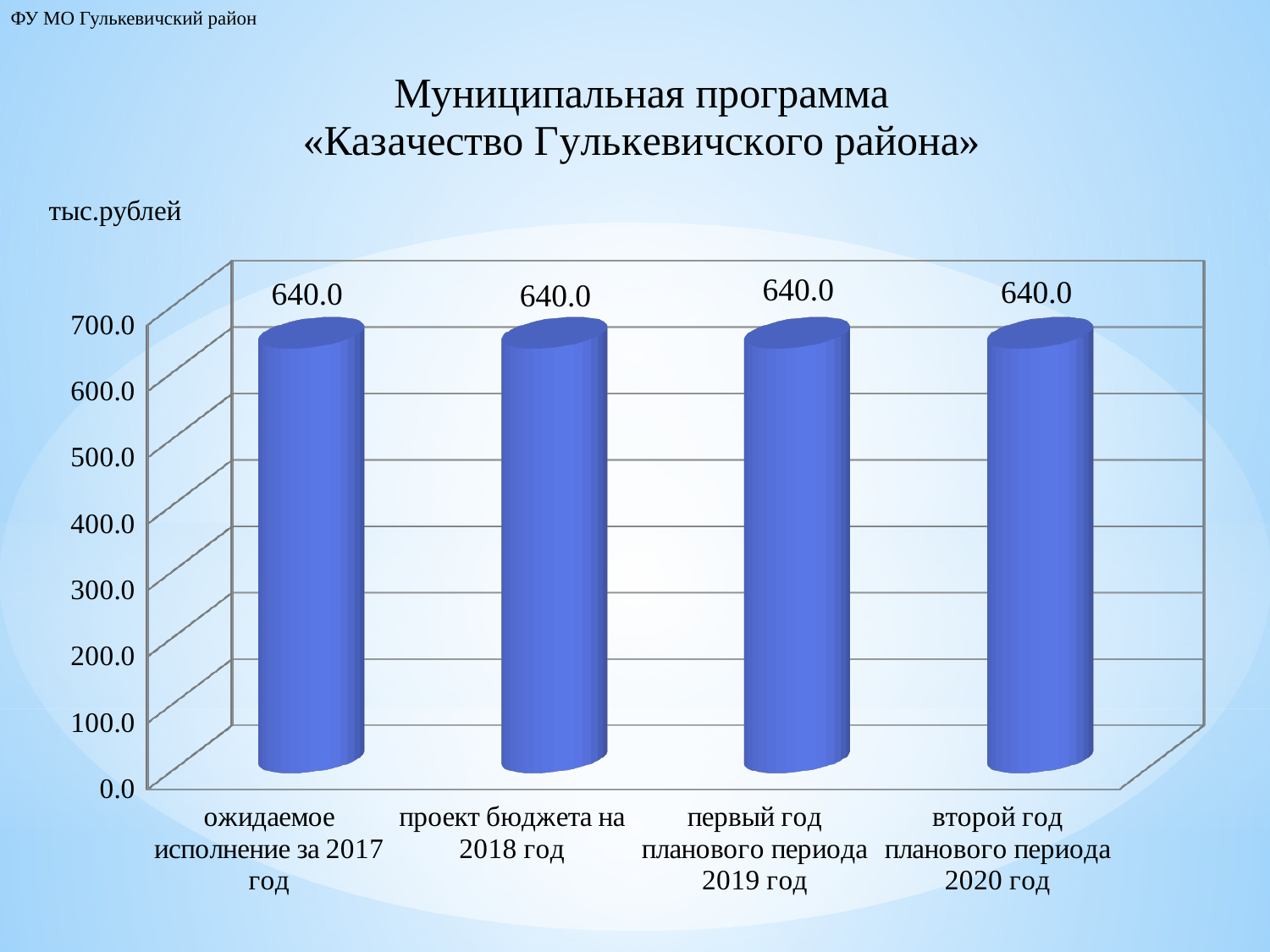
What is the value for "второй год планового периода 2020 год"? 640.0 What kind of chart is shown on the slide? bar chart What is the value for "первый год планового периода 2019 год"? 640.0 What unit is indicated for the values on the chart? тыс.рублей What is the title of the slide above the chart? Муниципальная программа «Казачество Гулькевичского района» Do the values rise, fall or stay the same from 2017 to 2020? stay the same How many categories are shown on the chart? 4 Is the value for "проект бюджета на 2018 год" greater or less than 600.0? greater What is the value for "проект бюджета на 2018 год"? 640.0 Is the value for "второй год планового периода 2020 год" greater or less than 700.0? less What is the difference between the value for 2018 and the value for 2017? 0.0 What is the value for "ожидаемое исполнение за 2017 год"? 640.0